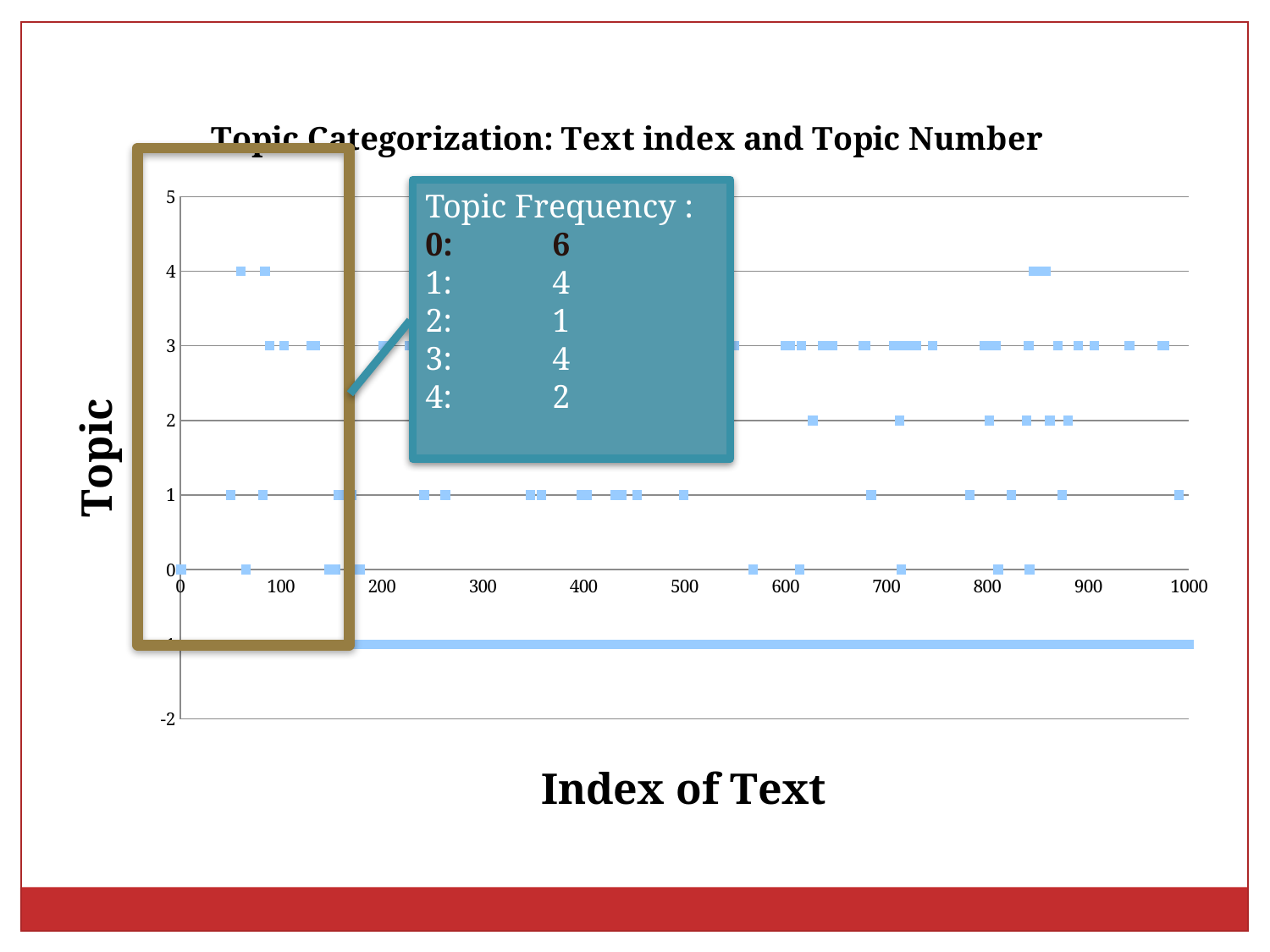
In the Topic Frequency callout, what is the frequency for topic 0? 6 What is the sum of all the frequencies listed in the Topic Frequency callout? 17 In the Topic Frequency callout, what is the frequency for topic 2? 1 In the Topic Frequency callout, is the frequency of topic 3 larger or smaller than the frequency of topic 4? larger How many topics are listed in the Topic Frequency callout? 5 According to the Topic Frequency callout, which topic has the highest frequency? 0 According to the Topic Frequency callout, which topic has the lowest frequency? 2 What kind of chart is shown on the slide? Scatter chart What is the title of the chart? Topic Categorization: Text index and Topic Number In the Topic Frequency callout, what is the difference between the frequency of topic 0 and the frequency of topic 1? 2 What is the label of the x axis? Index of Text In the Topic Frequency callout, what is the frequency for topic 4? 2